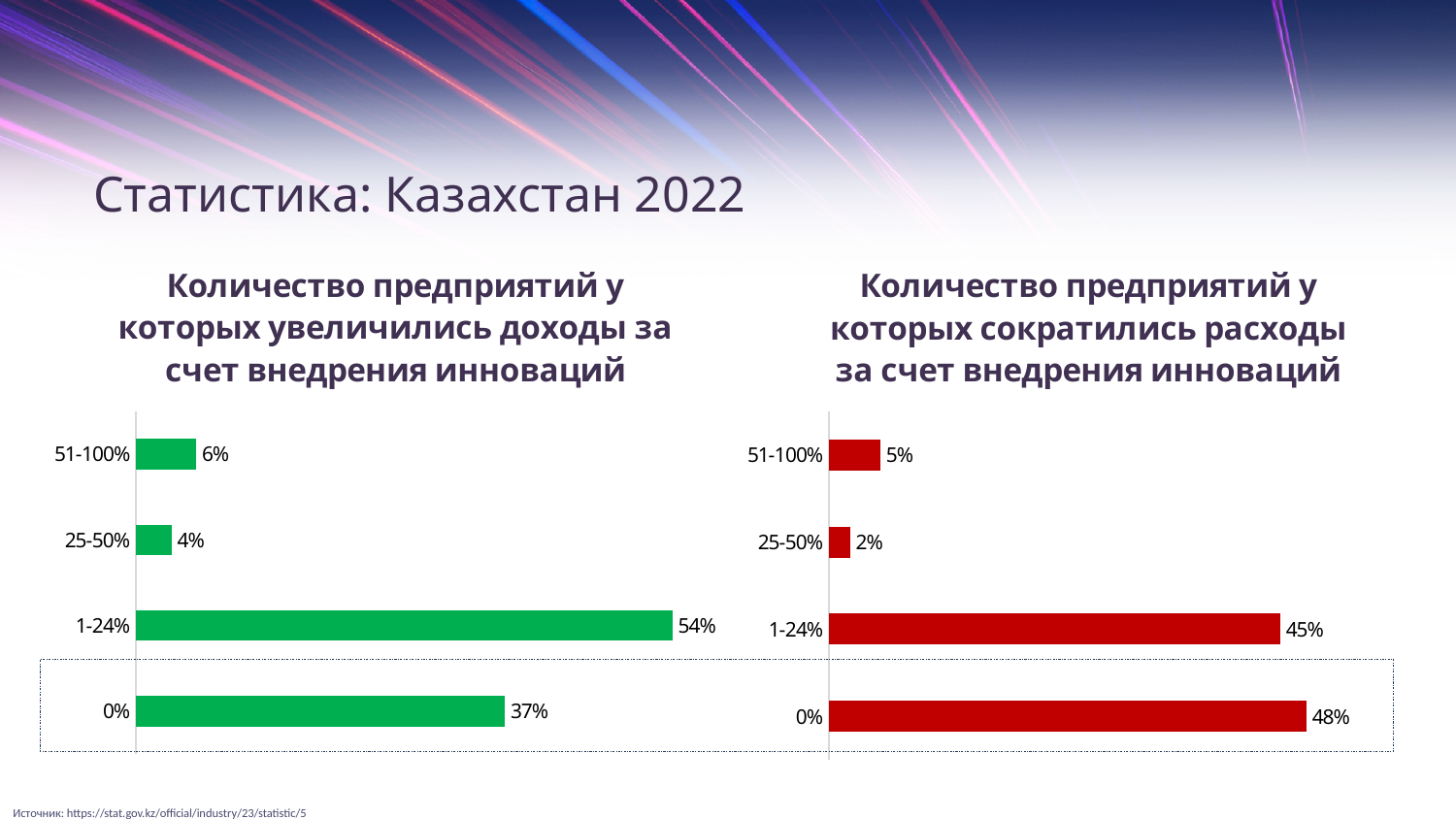
In the right chart (reduced expenses from innovation), which is larger: the value for 0% or the value for 1-24%? 0% What type of chart is the right chart (reduced expenses from innovation)? Bar chart In the right chart (reduced expenses from innovation), what is the value for the 0% category? 48% In the left chart (increased income from innovation), what is the difference between the 1-24% and 0% categories? 17% What colour are the bars in the left chart (increased income from innovation)? Green In the left chart (increased income from innovation), what is the value for the 1-24% category? 54% In the left chart (increased income from innovation), which category has the highest value? 1-24% In the right chart (reduced expenses from innovation), what is the difference between the 0% and 1-24% categories? 3% In the left chart (increased income from innovation), what is the value for the 25-50% category? 4% How many categories are shown in the left chart (increased income from innovation)? 4 In the right chart (reduced expenses from innovation), what is the value for the 51-100% category? 5% In the right chart (reduced expenses from innovation), which category has the lowest value? 25-50%